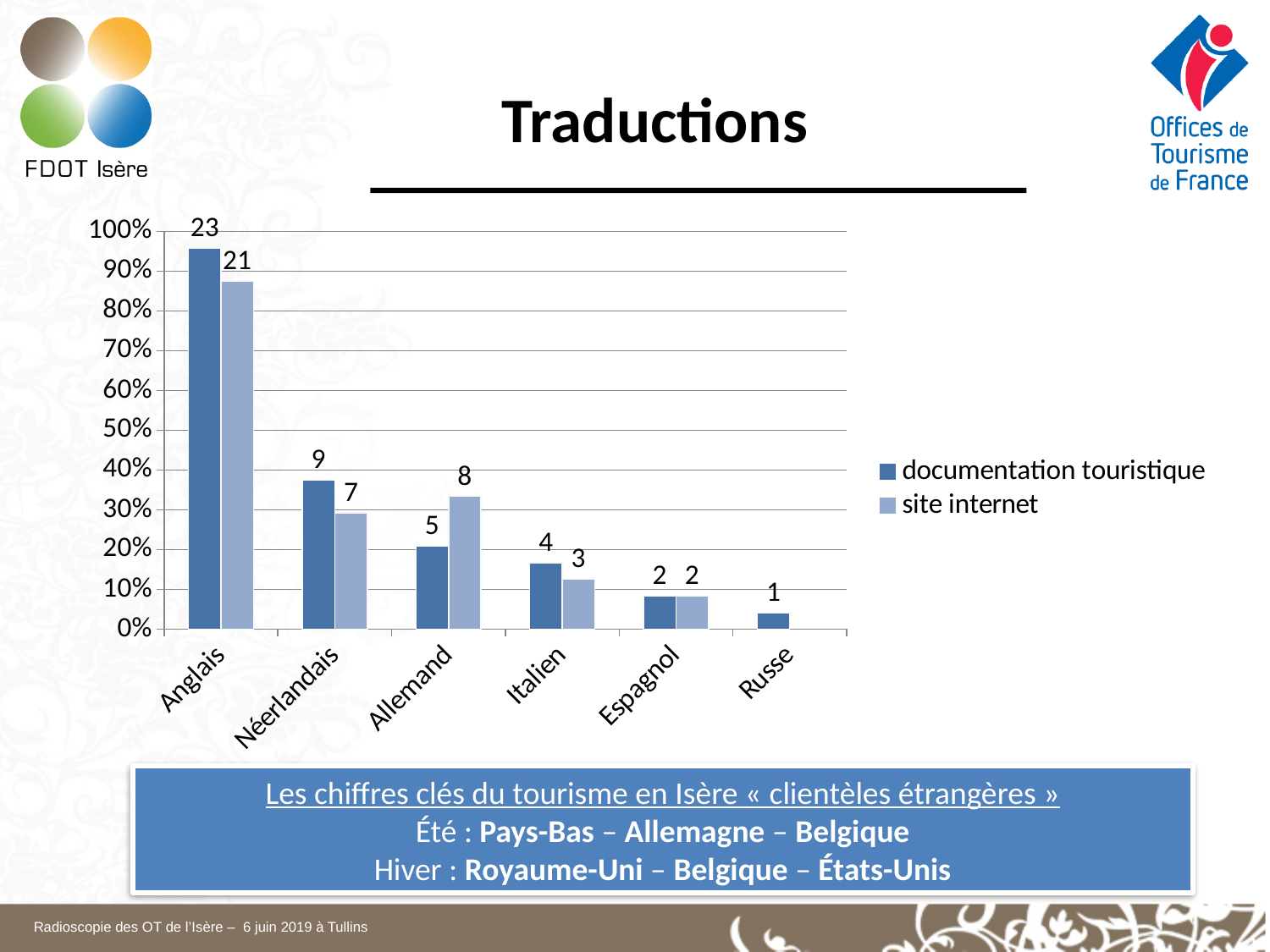
Is the 'documentation touristique' bar for Anglais greater or less than 90%? greater What is the data label for 'documentation touristique' for Anglais? 23 What is the data label for 'site internet' for Allemand? 8 What kind of chart is shown on the slide? bar chart How many series does the legend list? 2 What is the difference between the 'documentation touristique' and 'site internet' labels for Néerlandais? 2 What is the data label for 'site internet' for Anglais? 21 Which language has the highest value for 'documentation touristique'? Anglais What is the data label for 'documentation touristique' for Russe? 1 For Allemand, which series has the larger value: 'documentation touristique' or 'site internet'? site internet How many language categories are shown on the x axis? 6 Which language has the lowest value for 'documentation touristique'? Russe